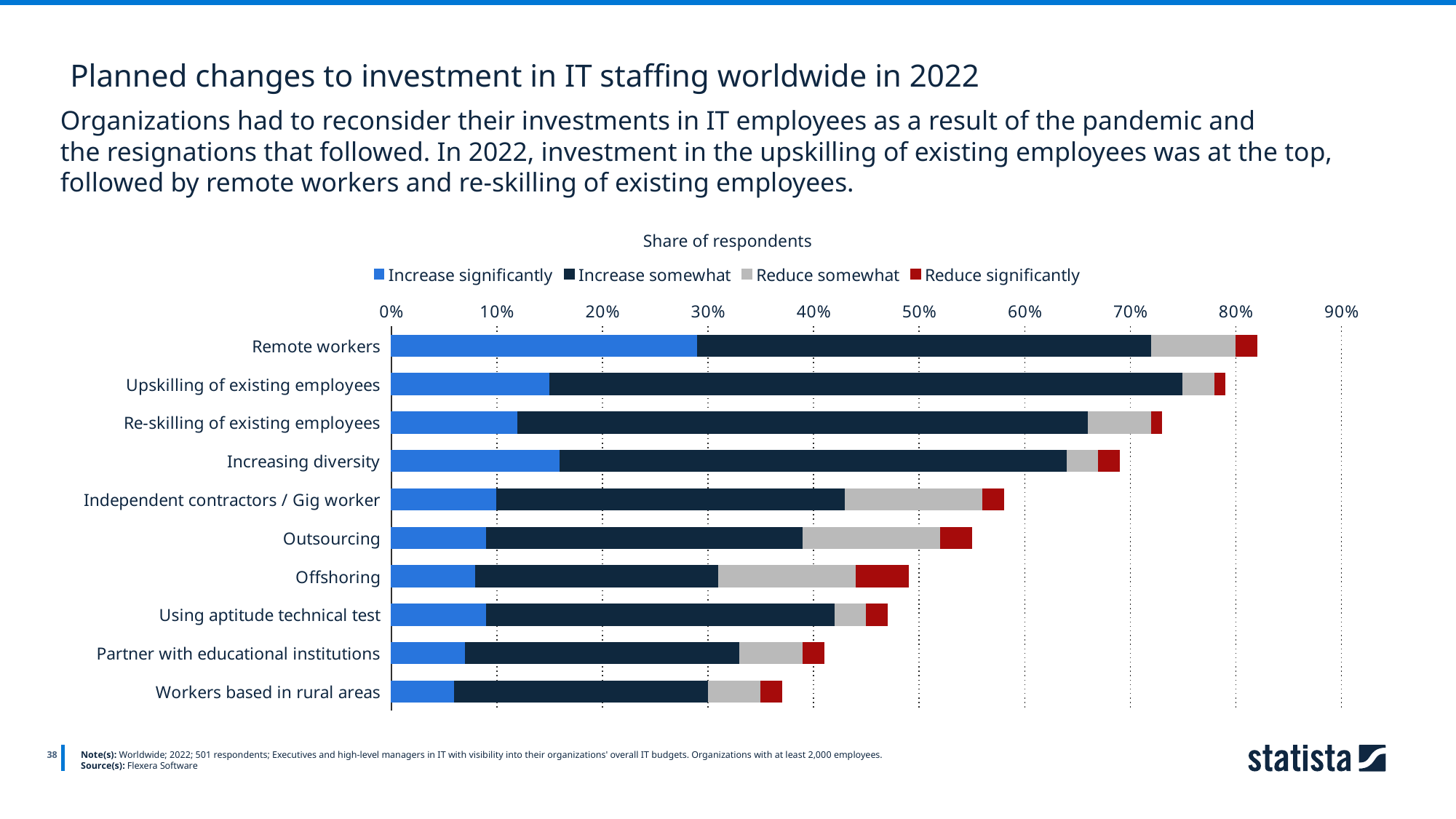
Is the total bar length for Workers based in rural areas greater or less than 50%? less Which category has the shortest total bar? Workers based in rural areas Is the total bar length for Outsourcing greater or less than 50%? greater Which category has the longest total bar? Remote workers Is the 'Increase significantly' value for Upskilling of existing employees greater or less than 20%? less What are the four series named in the legend? Increase significantly, Increase somewhat, Reduce somewhat, Reduce significantly What is the title of the chart on the slide? Planned changes to investment in IT staffing worldwide in 2022 Which has the larger 'Increase significantly' segment: Remote workers or Upskilling of existing employees? Remote workers How many series does the legend list? 4 How many categories (staffing investment areas) are plotted on the chart? 10 What kind of chart is shown on the slide? bar chart